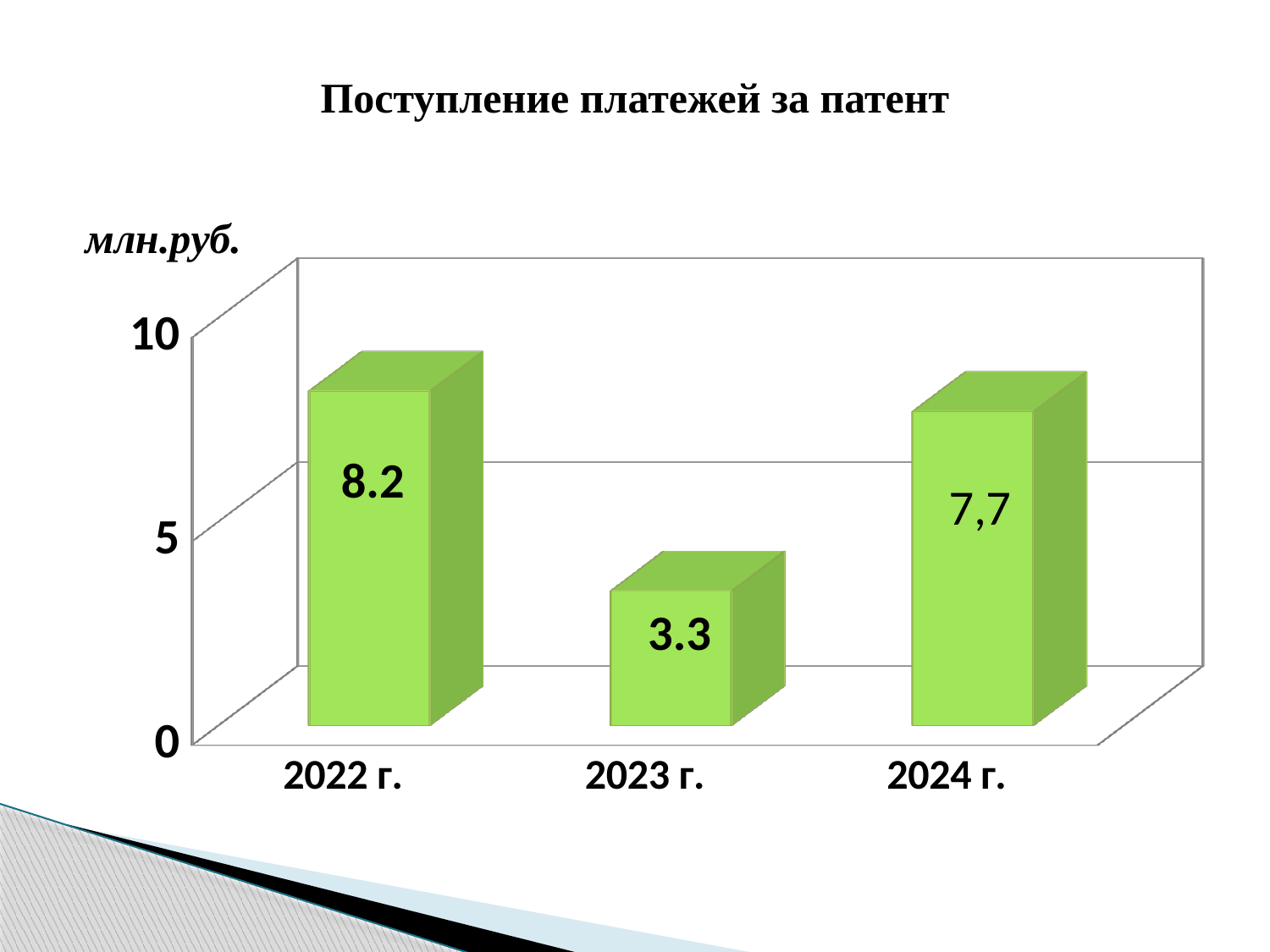
What is the title of the chart? Поступление платежей за патент Which year has the highest value? 2022 г. Which year has the lowest value? 2023 г. Which is larger, the value for 2023 г. or the value for 2024 г.? 2024 г. What kind of chart is shown on the slide? bar chart What is the difference between the values for 2022 г. and 2023 г.? 4.9 What is the value for 2024 г.? 7,7 How many years are shown on the chart? 3 Is the value for 2023 г. greater or less than 5? less What is the difference between the values for 2024 г. and 2023 г.? 4.4 What is the value for 2022 г.? 8.2 What is the value for 2023 г.? 3.3